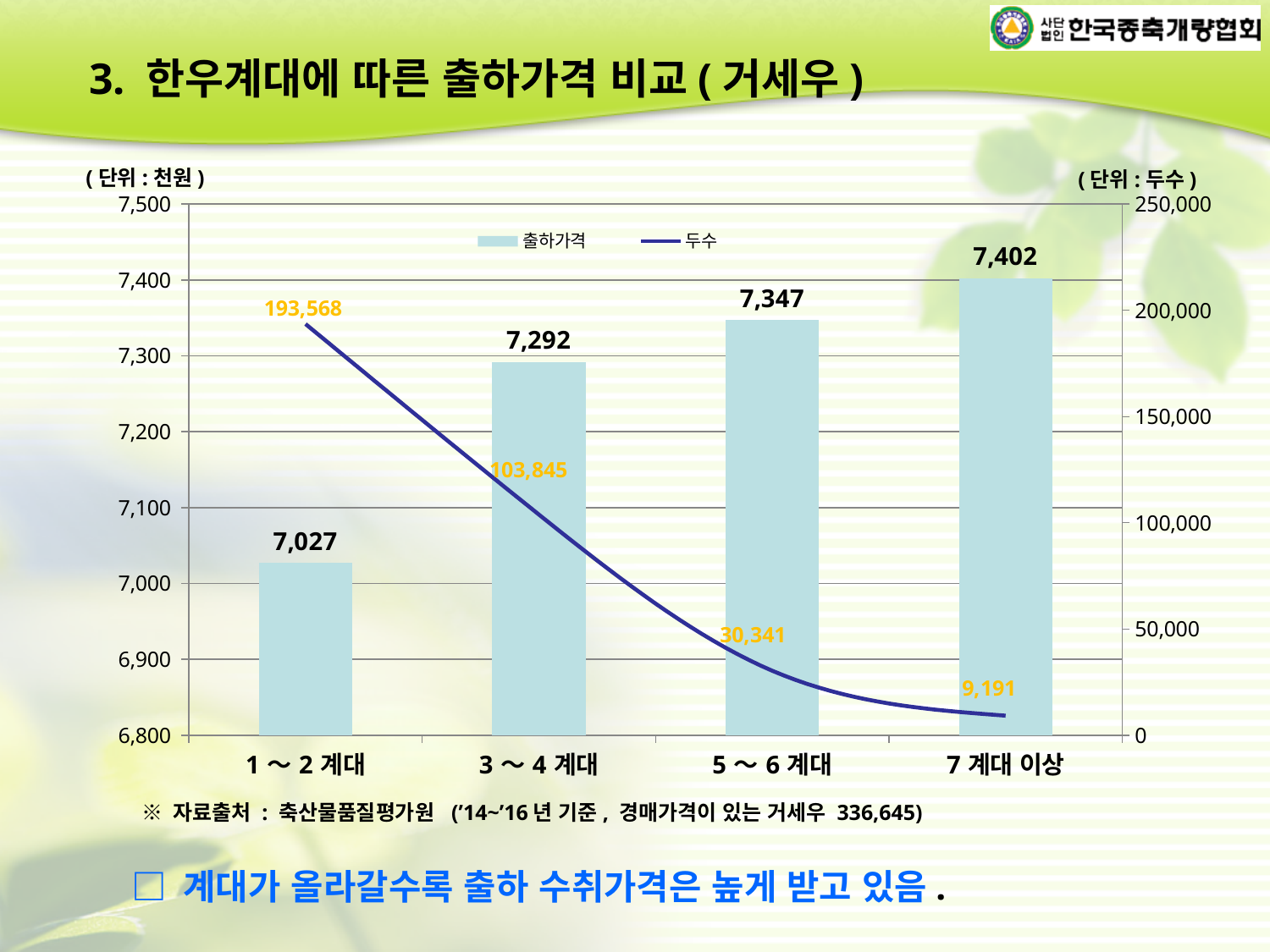
What is the 출하가격 value for 7 계대 이상? 7,402 What is the difference in 출하가격 between 7 계대 이상 and 1 ~ 2 계대? 375 How does the 두수 line change from 1 ~ 2 계대 to 7 계대 이상? It falls How many series does the legend list? 2 Which category has the lowest 두수? 7 계대 이상 Which category has the highest 출하가격? 7 계대 이상 Which has a larger 두수 value, 1 ~ 2 계대 or 3 ~ 4 계대? 1 ~ 2 계대 What is the 두수 value for 5 ~ 6 계대? 30,341 What is the 출하가격 value for 1 ~ 2 계대? 7,027 What is the 두수 value for 3 ~ 4 계대? 103,845 What unit is shown for the left axis? 천원 How many categories are shown on the x axis? 4